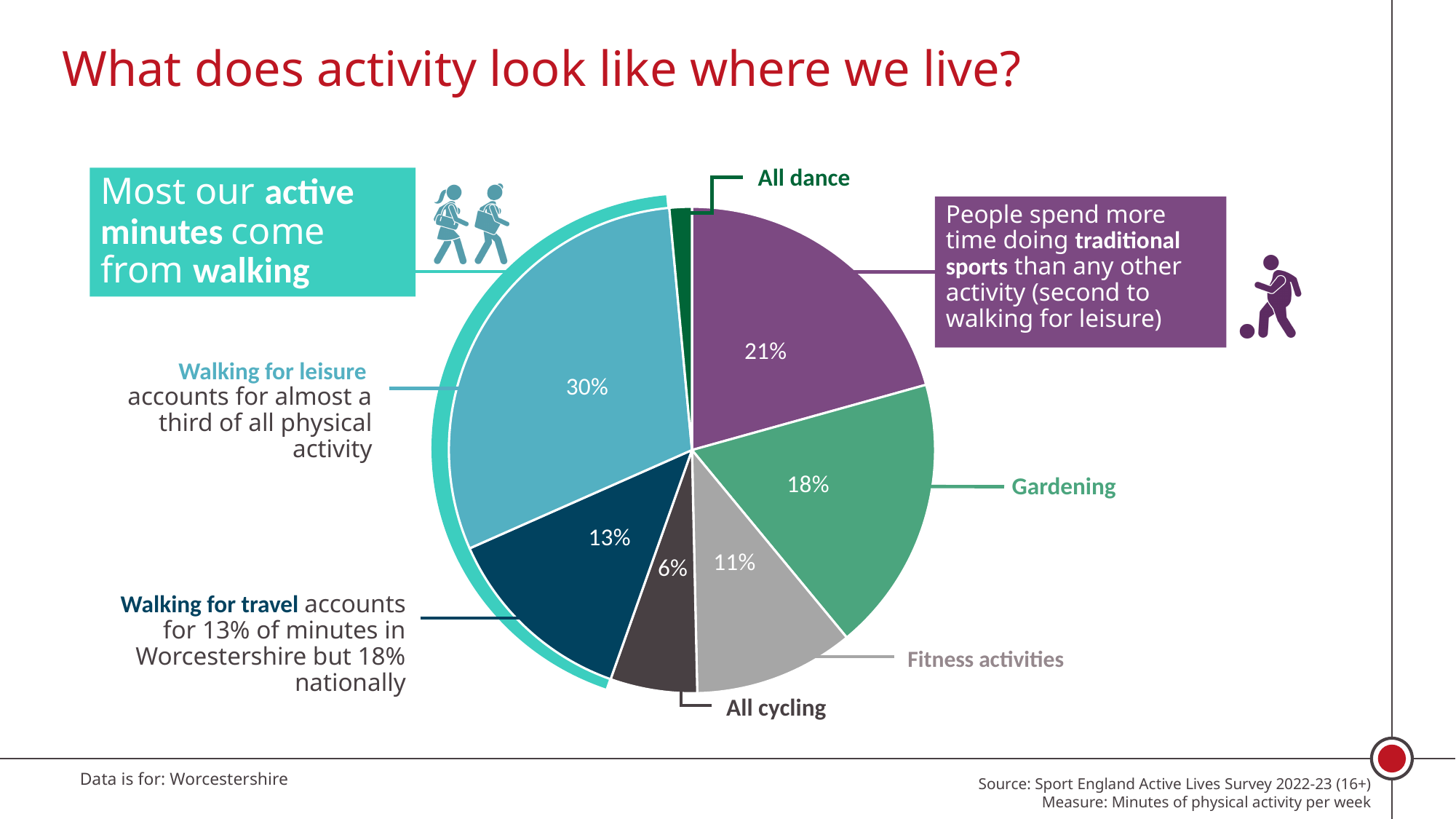
How many slices does the pie chart have? 7 What percentage of the pie is fitness activities? 11% What kind of chart is shown on the slide? pie chart How many percentage points larger is the walking for leisure slice than the gardening slice? 12 Which activity has the smallest slice of the pie? All dance What percentage of the pie is the traditional sports slice? 21% What percentage of the pie is walking for travel? 13% Which is larger, the fitness activities slice or the walking for travel slice? Walking for travel What percentage of the pie is all cycling? 6% What share of physical activity minutes does walking for leisure account for? 30% What percentage of the pie is gardening? 18% Which activity has the largest slice of the pie? Walking for leisure